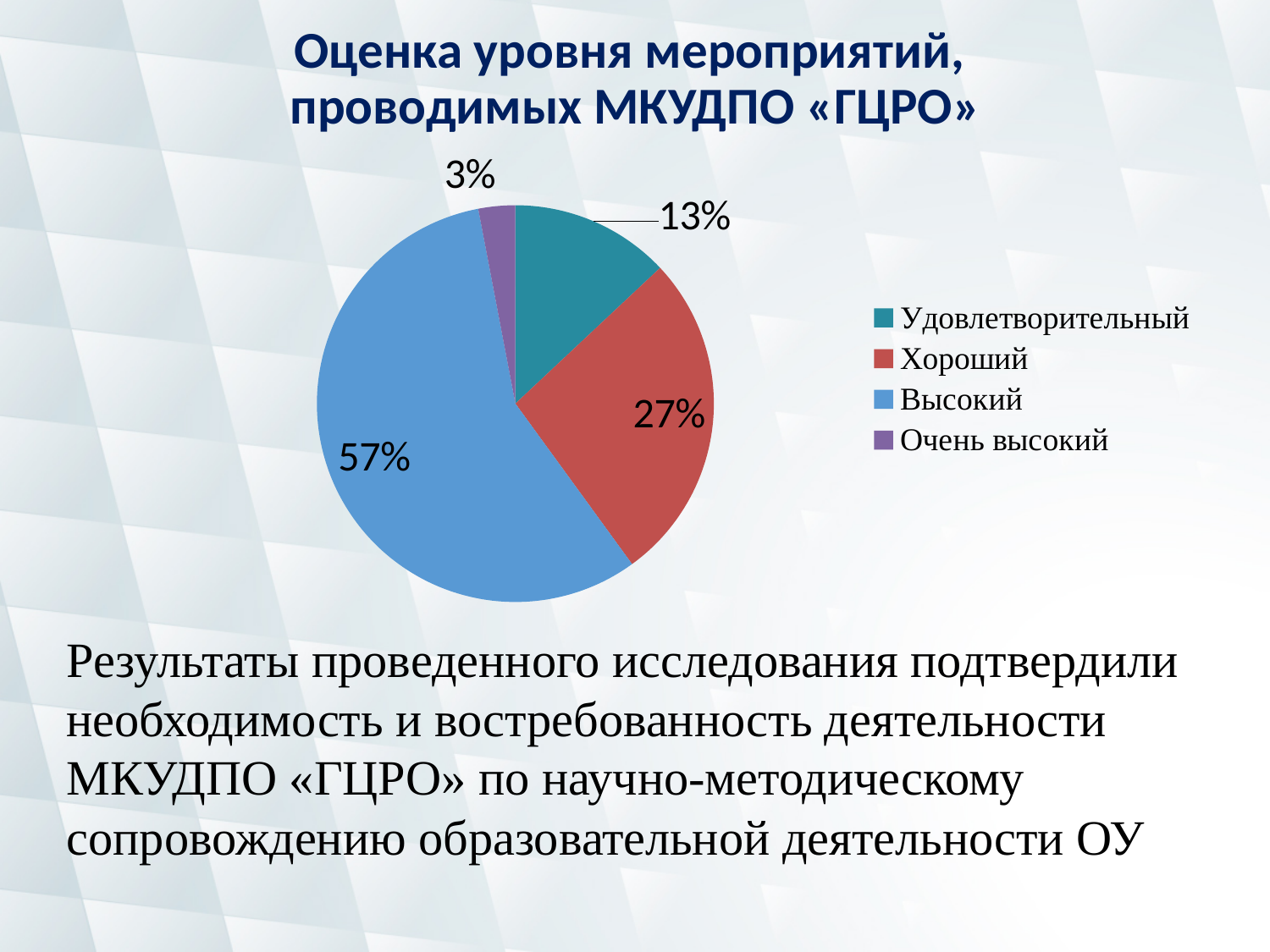
What share of the pie does "Очень высокий" have? 3% What colour is the slice for "Хороший"? red What share of the pie does "Высокий" have? 57% What is the title of the chart? Оценка уровня мероприятий, проводимых МКУДПО «ГЦРО» What kind of chart is shown on the slide? pie chart Which category has the largest slice of the pie? Высокий Which is larger, the share of "Хороший" or the share of "Удовлетворительный"? Хороший What share of the pie does "Хороший" have? 27% What is the difference between the shares of "Высокий" and "Хороший"? 30% How many categories does the pie chart have? 4 Which category has the smallest slice of the pie? Очень высокий